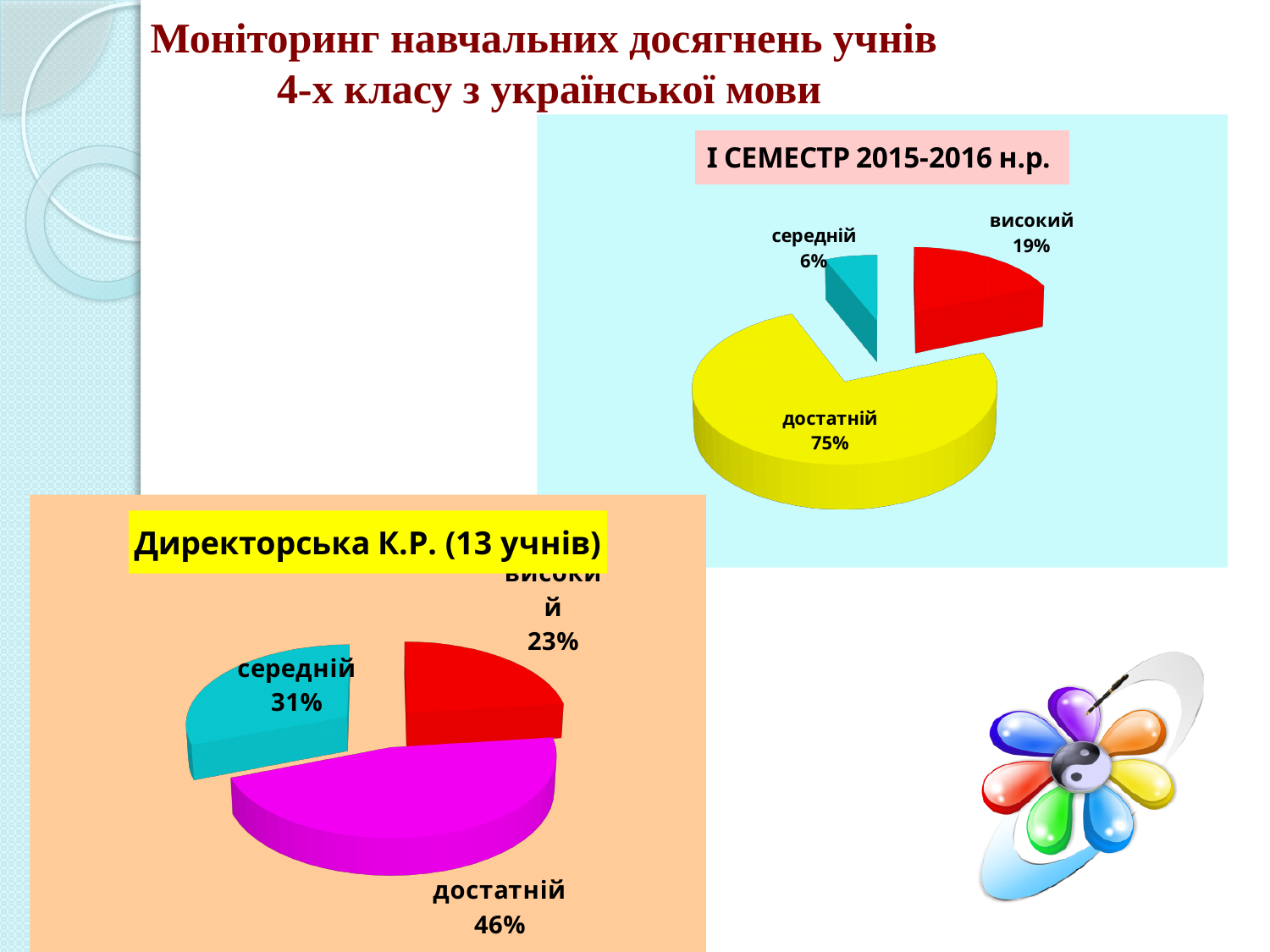
How many slices does the 'Директорська К.Р. (13 учнів)' pie chart have? 3 What type of chart is the 'І СЕМЕСТР 2015-2016 н.р.' chart? Pie chart In the 'І СЕМЕСТР 2015-2016 н.р.' pie chart, which category has the smallest slice? середній In the 'І СЕМЕСТР 2015-2016 н.р.' pie chart, what share is labelled for 'достатній'? 75% In the 'І СЕМЕСТР 2015-2016 н.р.' pie chart, what is the difference between the 'достатній' and 'високий' shares? 56% In the 'Директорська К.Р. (13 учнів)' pie chart, what share is labelled for 'високий'? 23% In the 'І СЕМЕСТР 2015-2016 н.р.' pie chart, what share is labelled for 'середній'? 6% In the 'І СЕМЕСТР 2015-2016 н.р.' pie chart, what share is labelled for 'високий'? 19% In the 'Директорська К.Р. (13 учнів)' pie chart, what share is labelled for 'достатній'? 46% In the 'Директорська К.Р. (13 учнів)' pie chart, which is larger, 'середній' or 'високий'? середній In the 'І СЕМЕСТР 2015-2016 н.р.' pie chart, which category has the largest slice? достатній In the 'Директорська К.Р. (13 учнів)' pie chart, what share is labelled for 'середній'? 31%